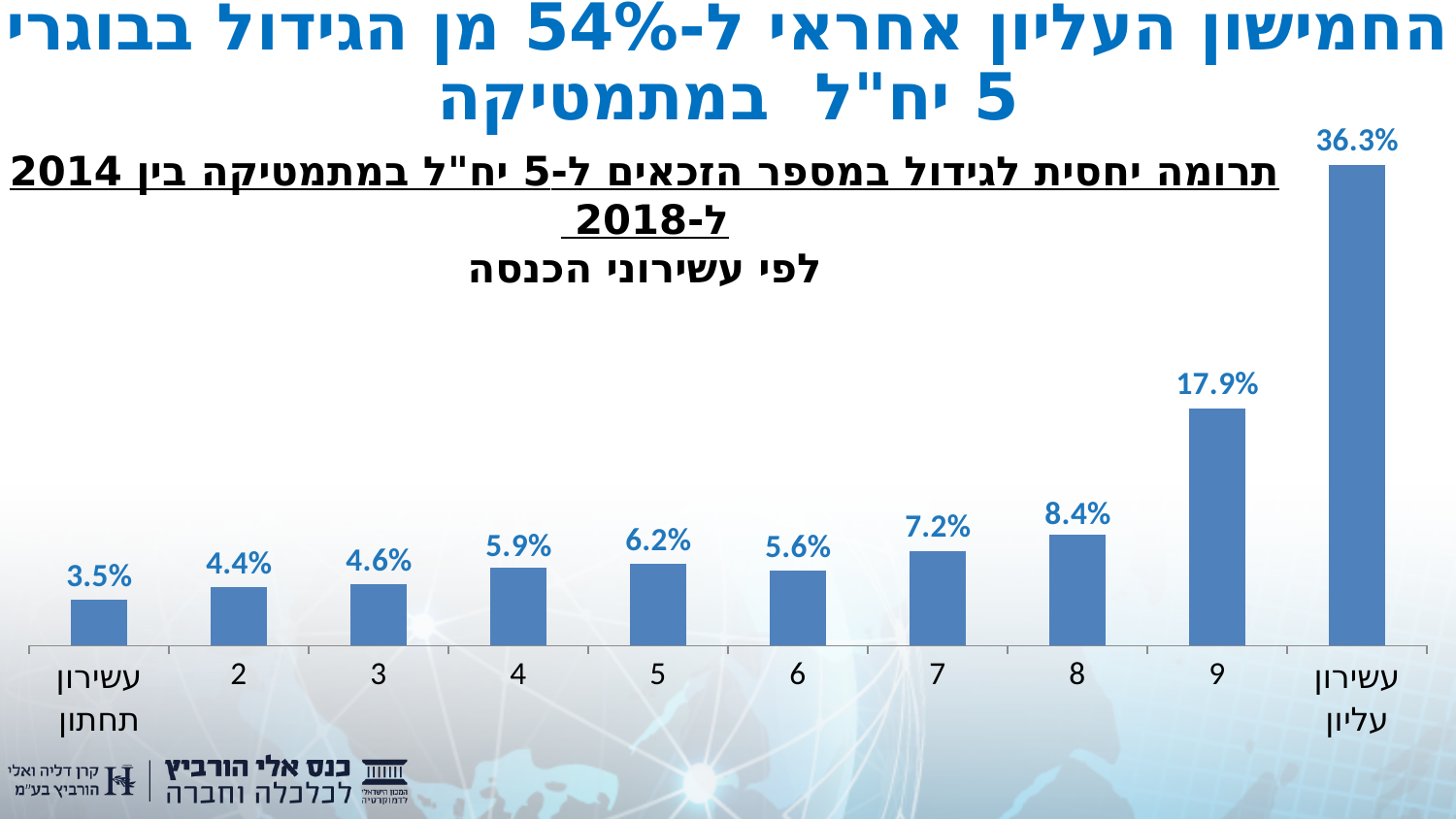
Which is larger, the value for decile 5 or decile 6? decile 5 What is the value for decile 9? 17.9% How many categories are shown on the x axis? 10 What is the value for decile 5? 6.2% What is the difference between the value for the top decile (עשירון עליון) and decile 9? 18.4% What is the value for the bottom decile (עשירון תחתון)? 3.5% Which category has the lowest value? עשירון תחתון What is the difference between the values for decile 8 and decile 7? 1.2% What kind of chart is shown on the slide? bar chart Do the values generally rise or fall from the bottom decile to the top decile? rise Which category has the highest value? עשירון עליון What colour are the bars in the chart? blue